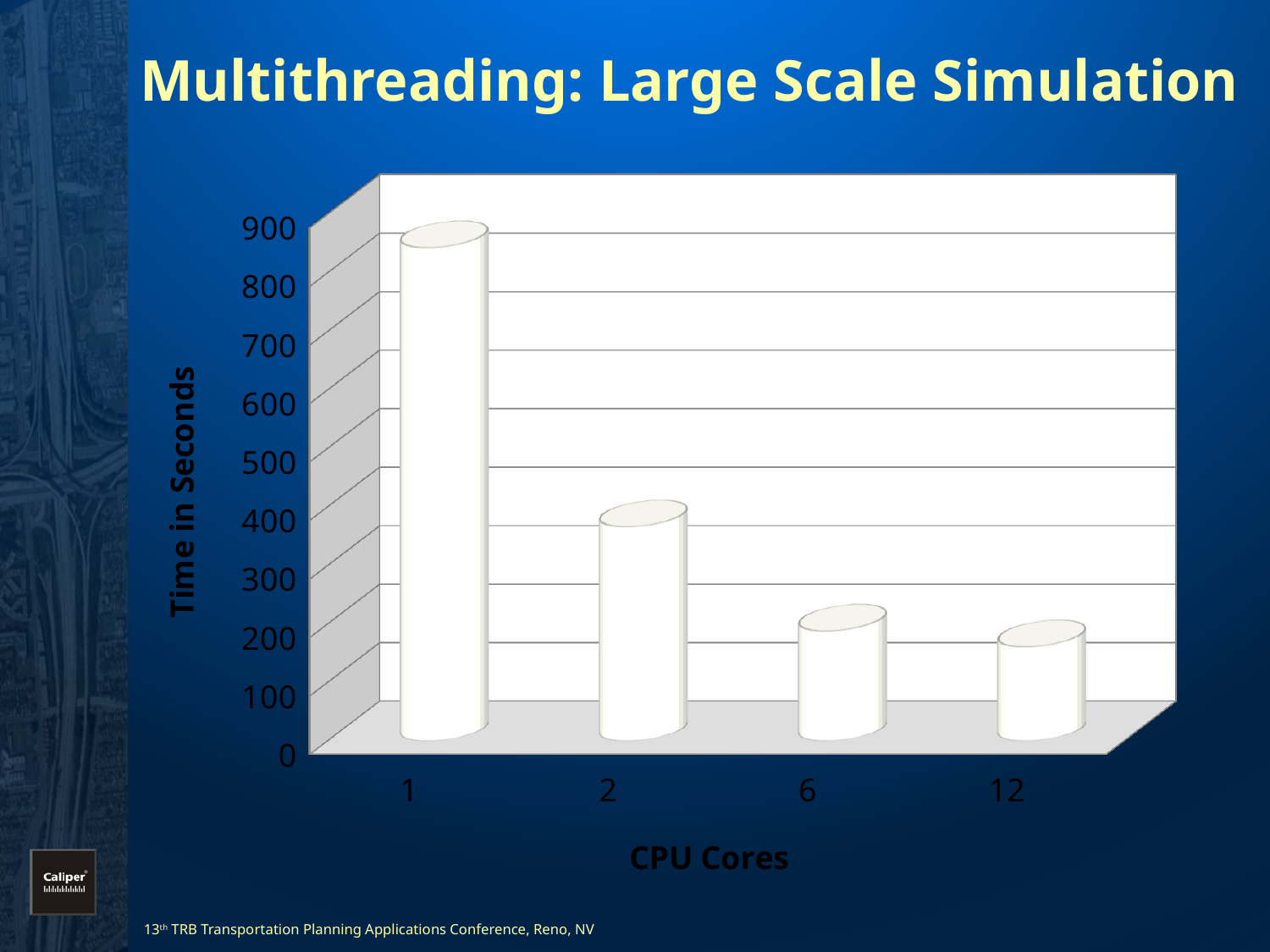
Is the time for 6 CPU cores greater or less than 300 seconds? less Do the times rise or fall as the number of CPU cores increases along the x axis? fall Is the time for 1 CPU core greater or less than 800 seconds? greater How many CPU core categories are plotted on the x axis? 4 Is the time for 12 CPU cores greater or less than 100 seconds? greater What is the label of the vertical axis? Time in Seconds Which has a larger time in seconds, 6 CPU cores or 12 CPU cores? 6 Which CPU core count has the lowest time in seconds? 12 What kind of chart is shown on the slide? bar chart Which CPU core count has the highest time in seconds? 1